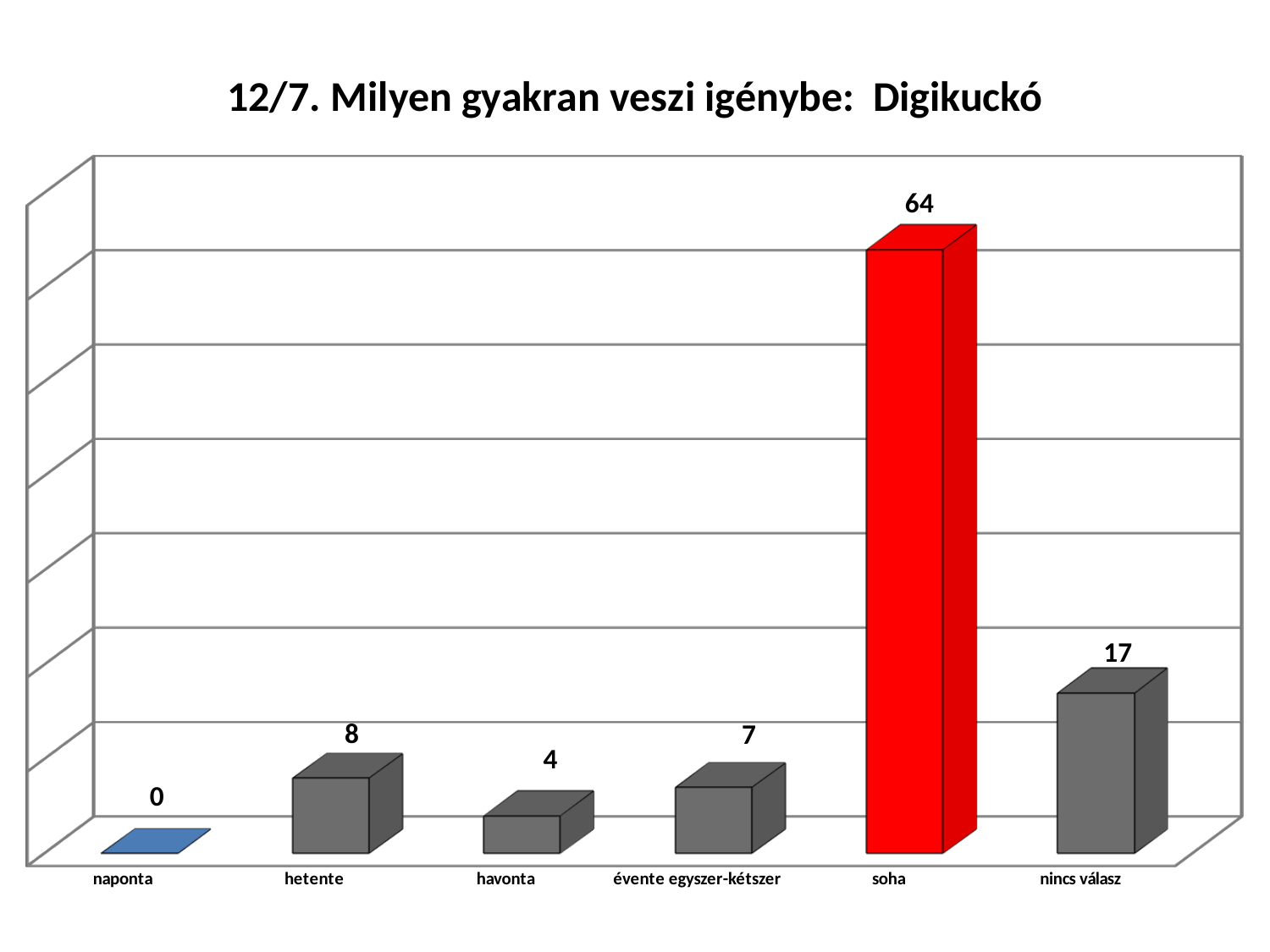
What is the value for "nincs válasz"? 17 What is the value for "soha"? 64 Which is larger, the value for "hetente" or the value for "évente egyszer-kétszer"? hetente What is the value for "hetente"? 8 What kind of chart is shown on the slide? bar chart What is the difference between the values for "soha" and "nincs válasz"? 47 Which category has the lowest value? naponta Which category has the highest value? soha How many categories are shown on the x axis? 6 What is the value for "naponta"? 0 What is the title of the chart? 12/7. Milyen gyakran veszi igénybe: Digikuckó What is the difference between the values for "hetente" and "havonta"? 4